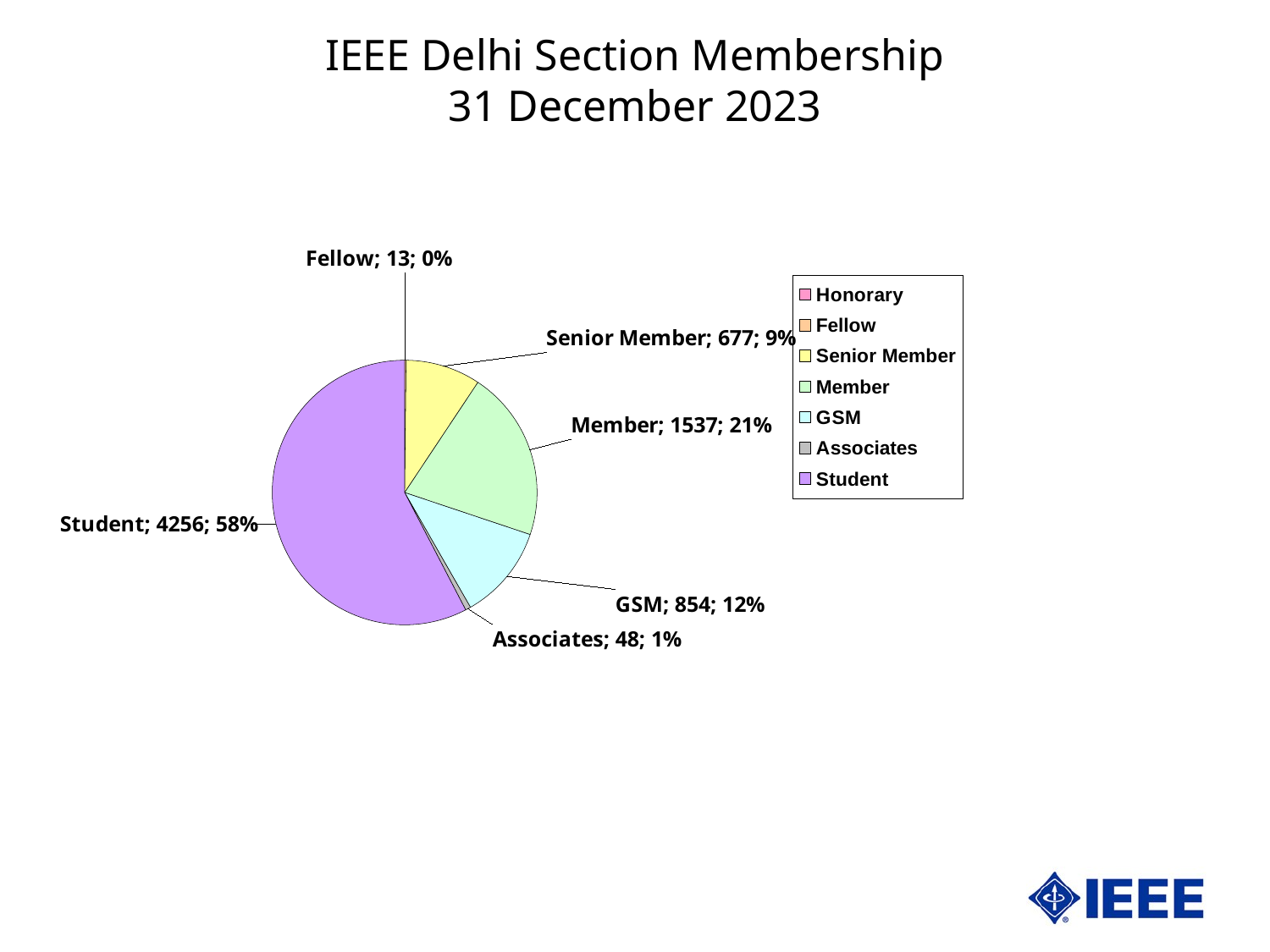
How many Student members are shown on the pie chart? 4256 What is the value shown for Associates? 48 What share of the pie does the Member slice represent? 21% Which category has the largest slice of the pie? Student Which is larger, the value for Senior Member or the value for GSM? GSM What is the value shown for GSM? 854 What is the value shown for Senior Member? 677 What kind of chart is shown on the slide? Pie chart What is the difference between the Member value and the GSM value? 683 What share of the pie does the GSM slice represent? 12% How many entries does the legend list? 7 What is the value shown for Fellow? 13